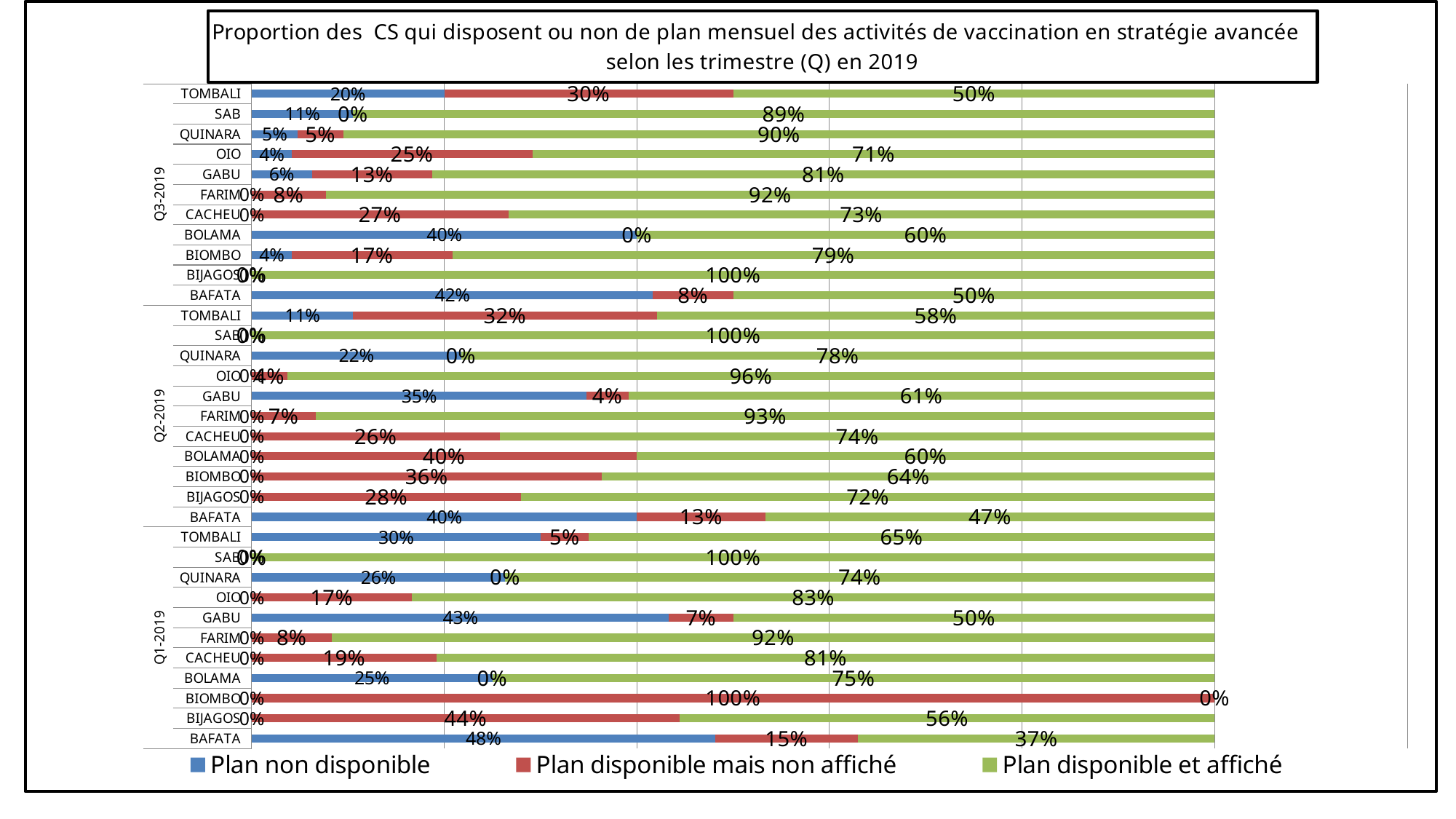
Which bar has the lowest value for 'Plan disponible et affiché'? BIOMBO in Q1-2019 Which bar has the highest value for 'Plan non disponible'? BAFATA in Q1-2019 What kind of chart is shown on the slide? Stacked bar chart How many series does the legend list? 3 For TOMBALI in Q3-2019, what is the difference between 'Plan disponible et affiché' and 'Plan non disponible'? 30 percentage points What is the value of 'Plan non disponible' for BAFATA in Q1-2019? 48% What is the value of 'Plan disponible et affiché' for TOMBALI in Q3-2019? 50% Which is larger: 'Plan disponible et affiché' for GABU in Q3-2019 or for GABU in Q2-2019? GABU in Q3-2019 What is the value of 'Plan disponible mais non affiché' for BIOMBO in Q1-2019? 100% Which colour represents 'Plan disponible mais non affiché' in the legend? Red What is the value of 'Plan disponible mais non affiché' for BIJAGOS in Q2-2019? 28% How many bars (region-quarter combinations) are plotted on the chart? 33